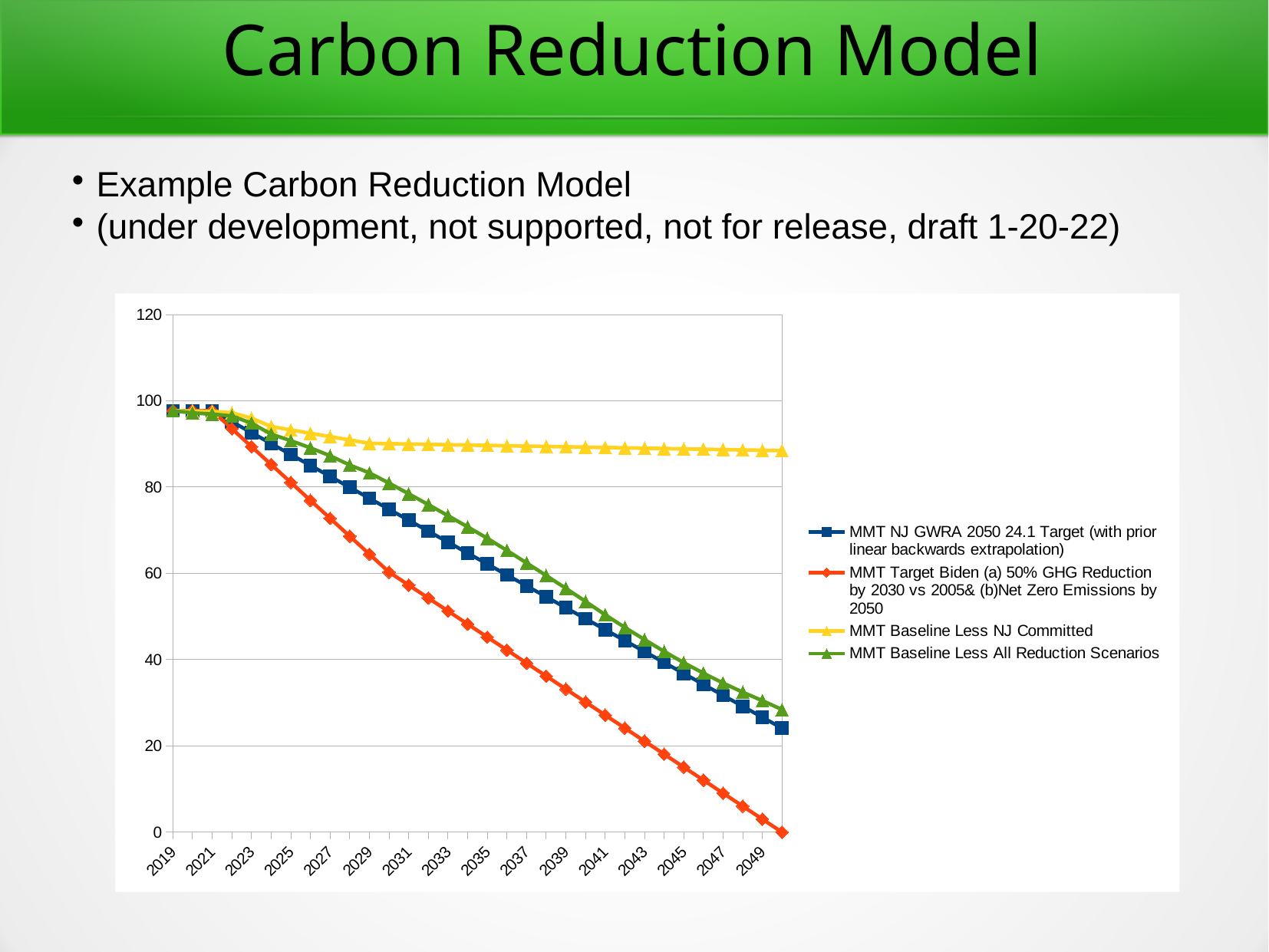
What colour is the line for the MMT Baseline Less NJ Committed series? yellow Is the value of the MMT NJ GWRA 2050 24.1 Target series at 2035 greater or less than 60? greater Is the value of the MMT Baseline Less All Reduction Scenarios series at 2049 greater or less than 40? less Does the MMT Target Biden series rise or fall from 2019 to 2049? fall Is the value of the MMT Target Biden series at 2049 greater or less than 20? less Which series has the highest value at 2049? MMT Baseline Less NJ Committed How many series does the legend list? 4 How many year labels are shown on the x axis? 16 Which series has the lowest value at 2049? MMT Target Biden (a) 50% GHG Reduction by 2030 vs 2005& (b)Net Zero Emissions by 2050 At 2041, which is larger: the MMT Baseline Less All Reduction Scenarios series or the MMT Target Biden series? MMT Baseline Less All Reduction Scenarios What kind of chart is shown on the slide? line chart